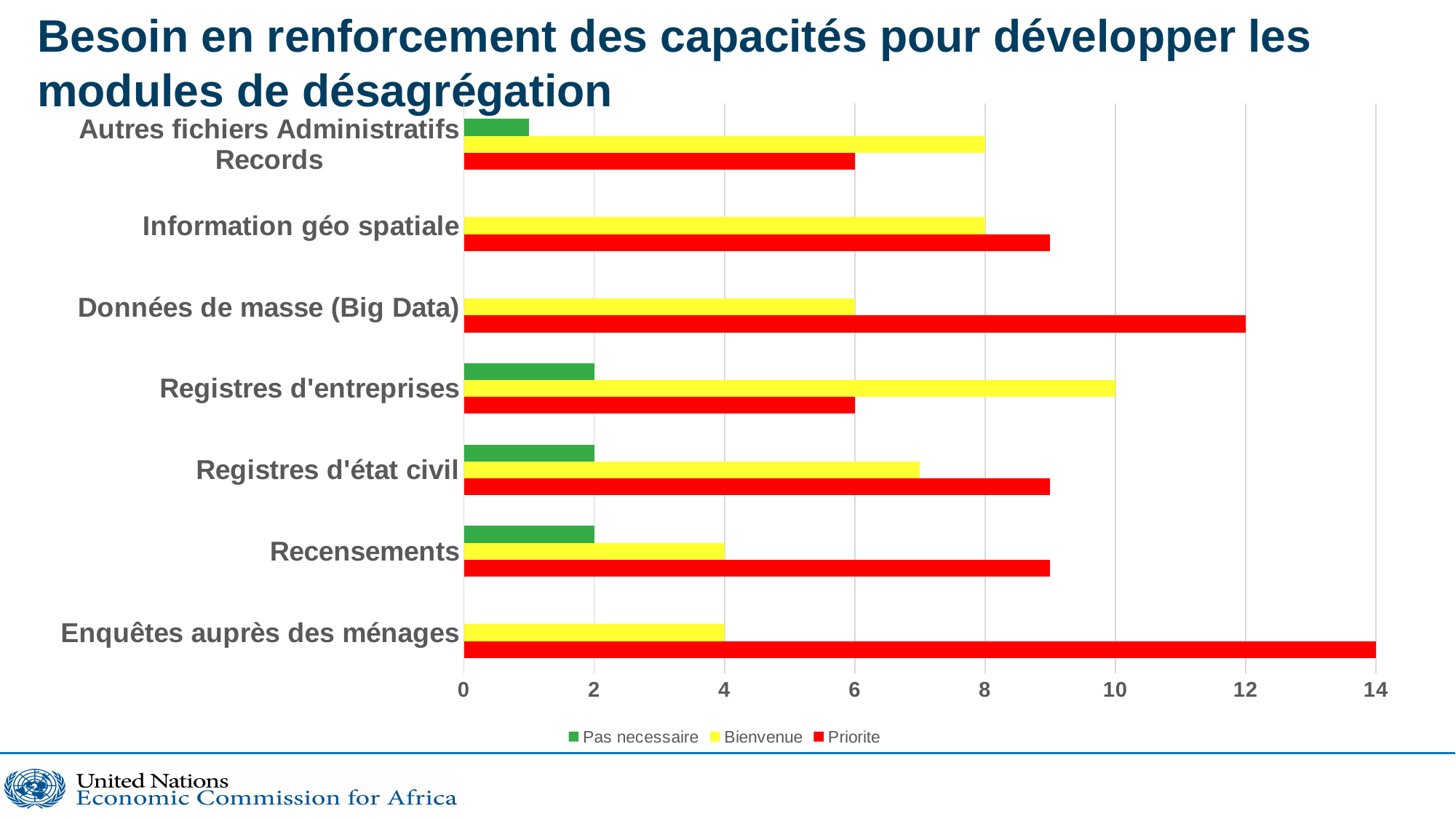
What is the Priorite value for Données de masse (Big Data)? 12 What kind of chart is shown on the slide? bar chart How many categories are shown on the chart? 7 Is the Priorite value for Information géo spatiale greater or less than 8? greater Which colour represents the Priorite series in the legend? red Which is larger for Registres d'entreprises: the Bienvenue value or the Priorite value? Bienvenue What is the difference between the Priorite value for Enquêtes auprès des ménages and the Priorite value for Données de masse (Big Data)? 2 How many series does the legend list? 3 What is the Bienvenue value for Registres d'entreprises? 10 Which category has the highest Priorite value? Enquêtes auprès des ménages What is the Priorite value for Enquêtes auprès des ménages? 14 Which category has the highest Bienvenue value? Registres d'entreprises